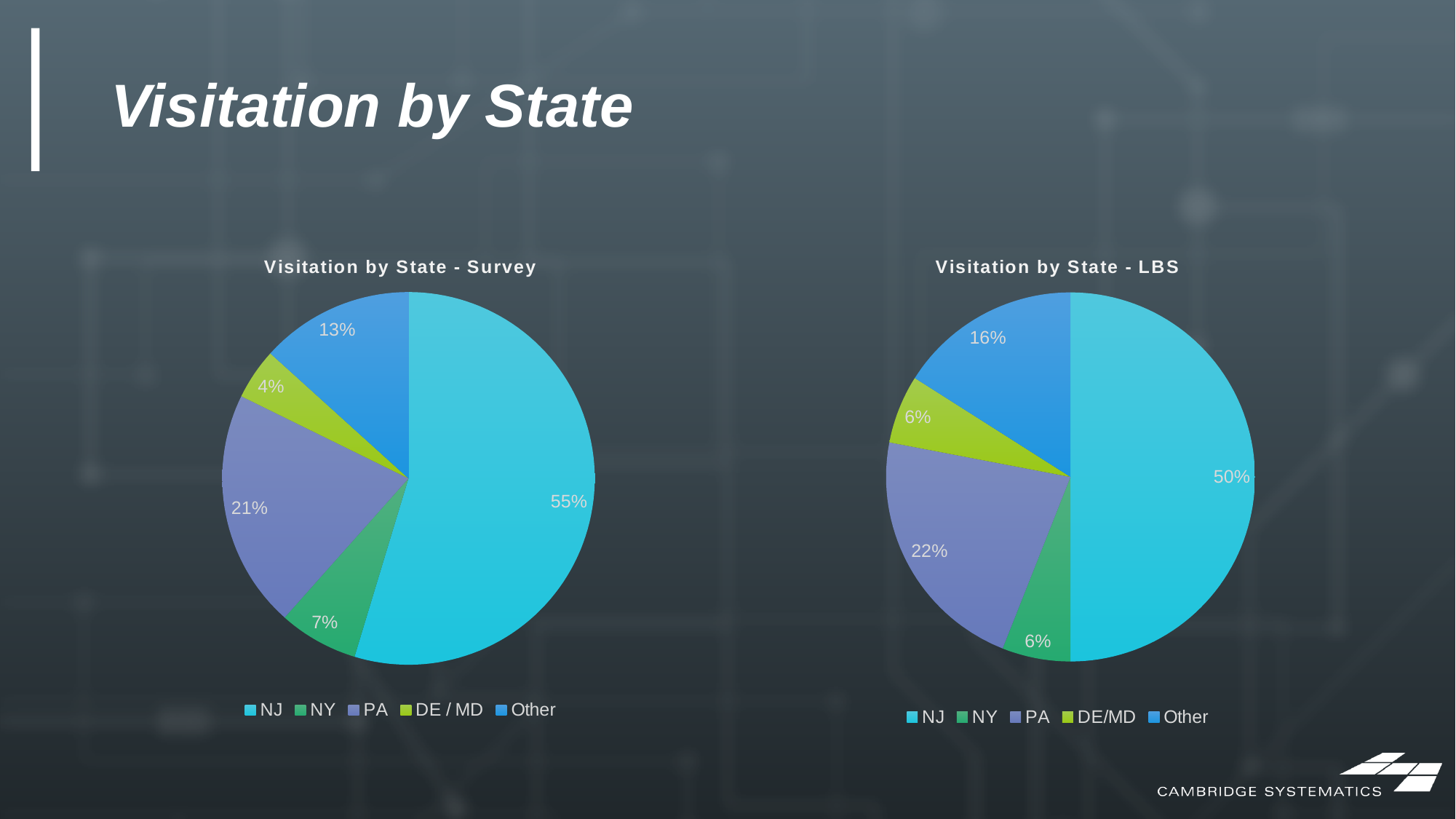
What type of chart is 'Visitation by State - Survey'? Pie chart In the 'Visitation by State - LBS' chart, which state has the largest share? NJ What is the difference between the NJ share in the Survey chart and the NJ share in the LBS chart? 5 percentage points In the 'Visitation by State - LBS' chart, what share does Other have? 16% In the 'Visitation by State - Survey' chart, what share does DE / MD have? 4% In the 'Visitation by State - LBS' chart, what share does PA have? 22% In the 'Visitation by State - Survey' chart, which is larger, the share for PA or the share for Other? PA In the 'Visitation by State - Survey' chart, which state has the largest share? NJ In the 'Visitation by State - Survey' chart, which category has the smallest share? DE / MD How many slices does the 'Visitation by State - LBS' pie chart have? 5 How many entries does the legend of the 'Visitation by State - Survey' chart list? 5 In the 'Visitation by State - Survey' chart, what share does NJ have? 55%